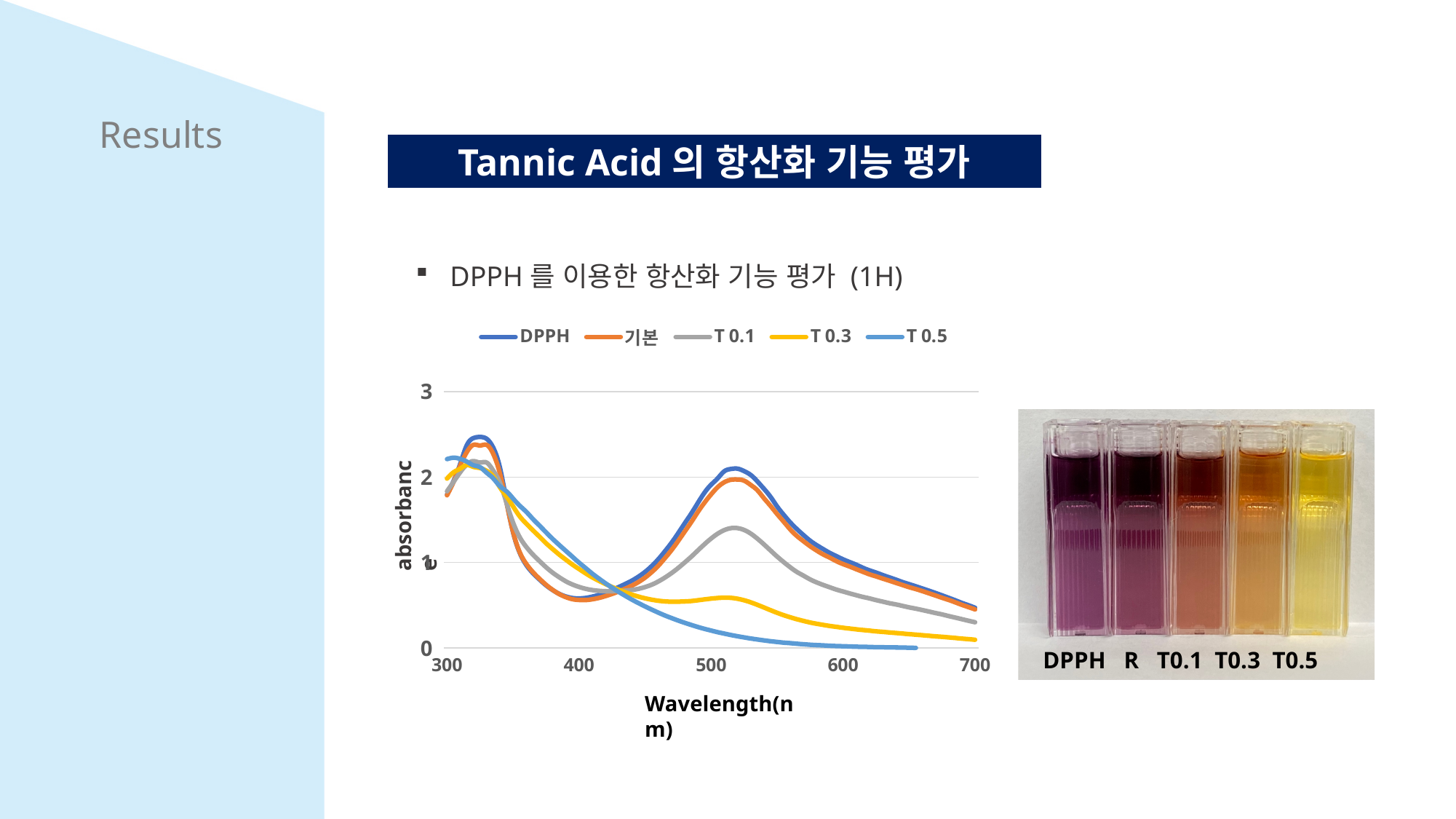
Which series has the lowest absorbance at 600 nm? T 0.5 Is the absorbance of the 기본 series at 520 nm greater or less than 1? greater At around 520 nm, which series has the higher absorbance, DPPH or T 0.3? DPPH What is the label of the chart's x axis? Wavelength(nm) Is the absorbance of the T 0.5 series at 600 nm greater or less than 1? less How many series does the chart's legend list? 5 Is the absorbance of the T 0.3 series at 520 nm greater or less than 1? less What kind of chart is shown on the slide? line chart Which series has the highest absorbance peak near 520 nm? DPPH Does the absorbance of the T 0.5 series rise or fall as the wavelength increases from 400 nm to 600 nm? fall What are the series names listed in the chart's legend? DPPH, 기본, T 0.1, T 0.3, T 0.5